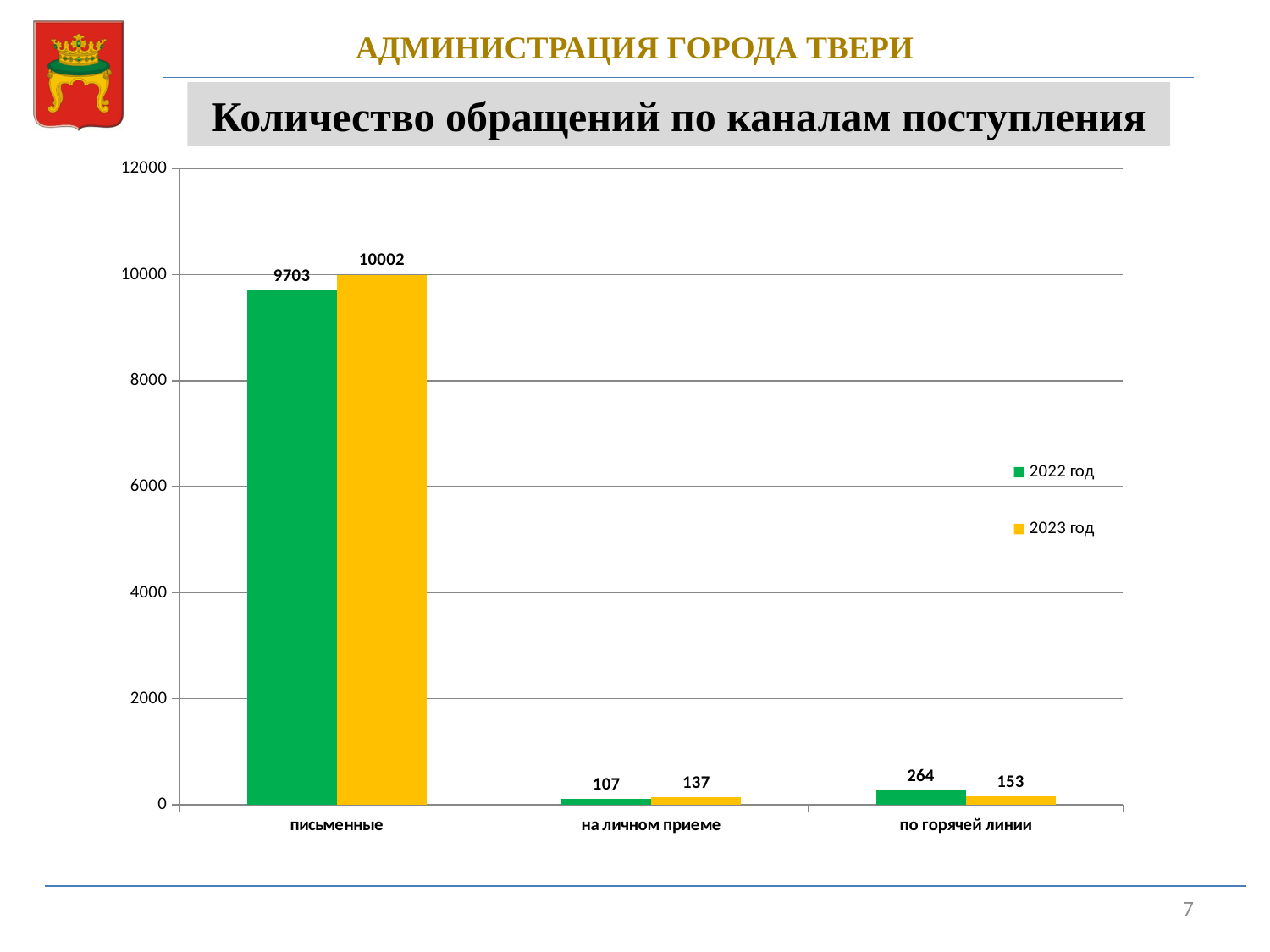
How many series does the legend list? 2 What is the value for на личном приеме in 2023 год? 137 What kind of chart is shown on the slide? bar chart Which is larger for на личном приеме: the 2022 год value or the 2023 год value? 2023 год What is the value for письменные in 2022 год? 9703 What is the value for по горячей линии in 2022 год? 264 Which category has the lowest value in 2022 год? на личном приеме What is the value for письменные in 2023 год? 10002 What is the difference between the 2022 год and 2023 год values for по горячей линии? 111 Which category has the highest value in 2023 год? письменные What is the difference between the 2023 год and 2022 год values for письменные? 299 How many categories are shown on the x axis? 3